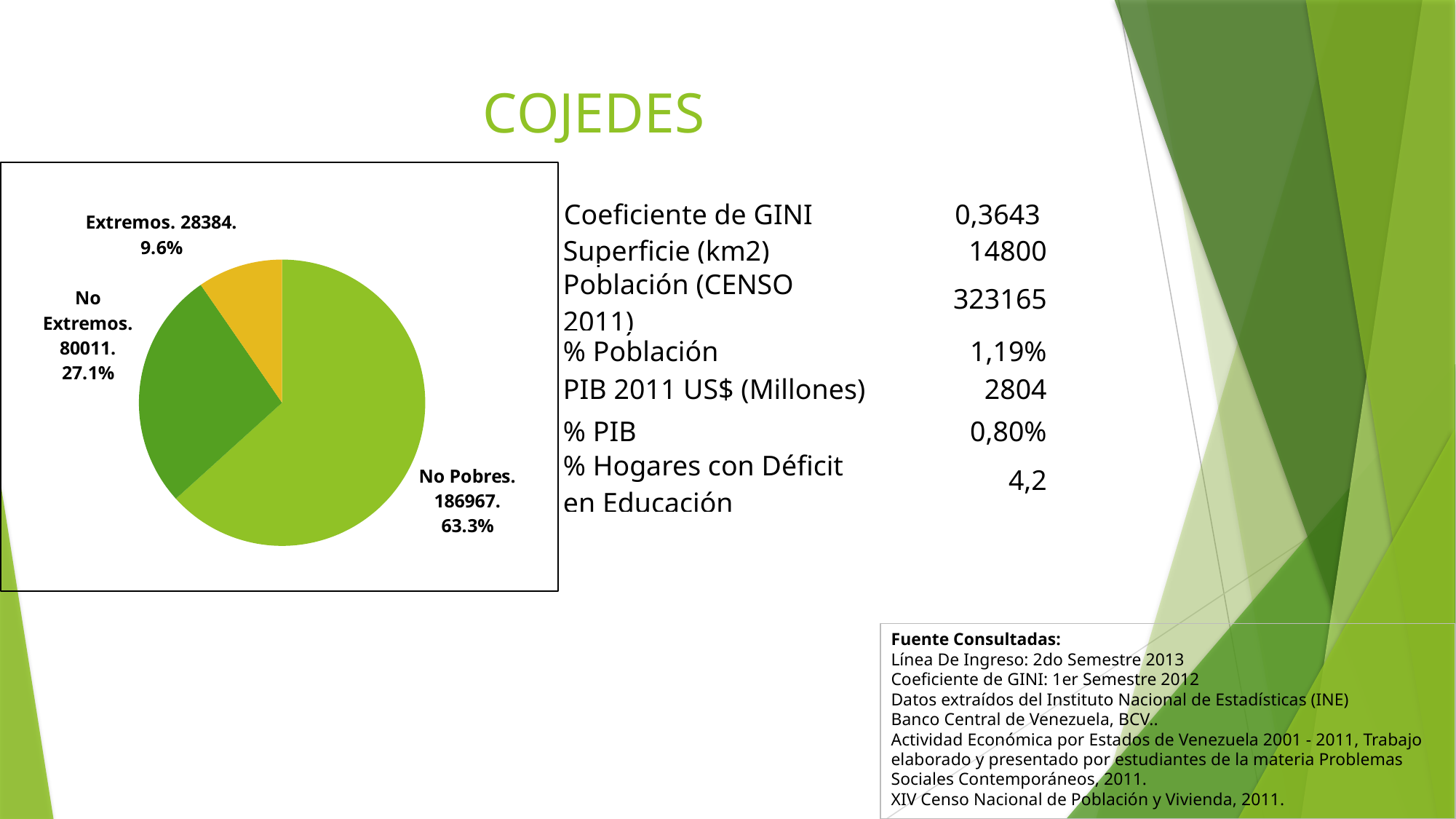
What share of the pie does the Extremos slice represent? 9.6% What share of the pie does the No Pobres slice represent? 63.3% What colour is the Extremos slice in the pie chart? yellow What is the value shown for the Extremos slice? 28384 How many slices does the pie chart have? 3 What is the value shown for the No Pobres slice? 186967 What is the difference between the No Extremos value and the Extremos value? 51627 Which slice of the pie chart is the smallest? Extremos What kind of chart is shown on the slide? pie chart Which is larger, the No Extremos slice or the Extremos slice? No Extremos What is the value shown for the No Extremos slice? 80011 Which slice of the pie chart is the largest? No Pobres